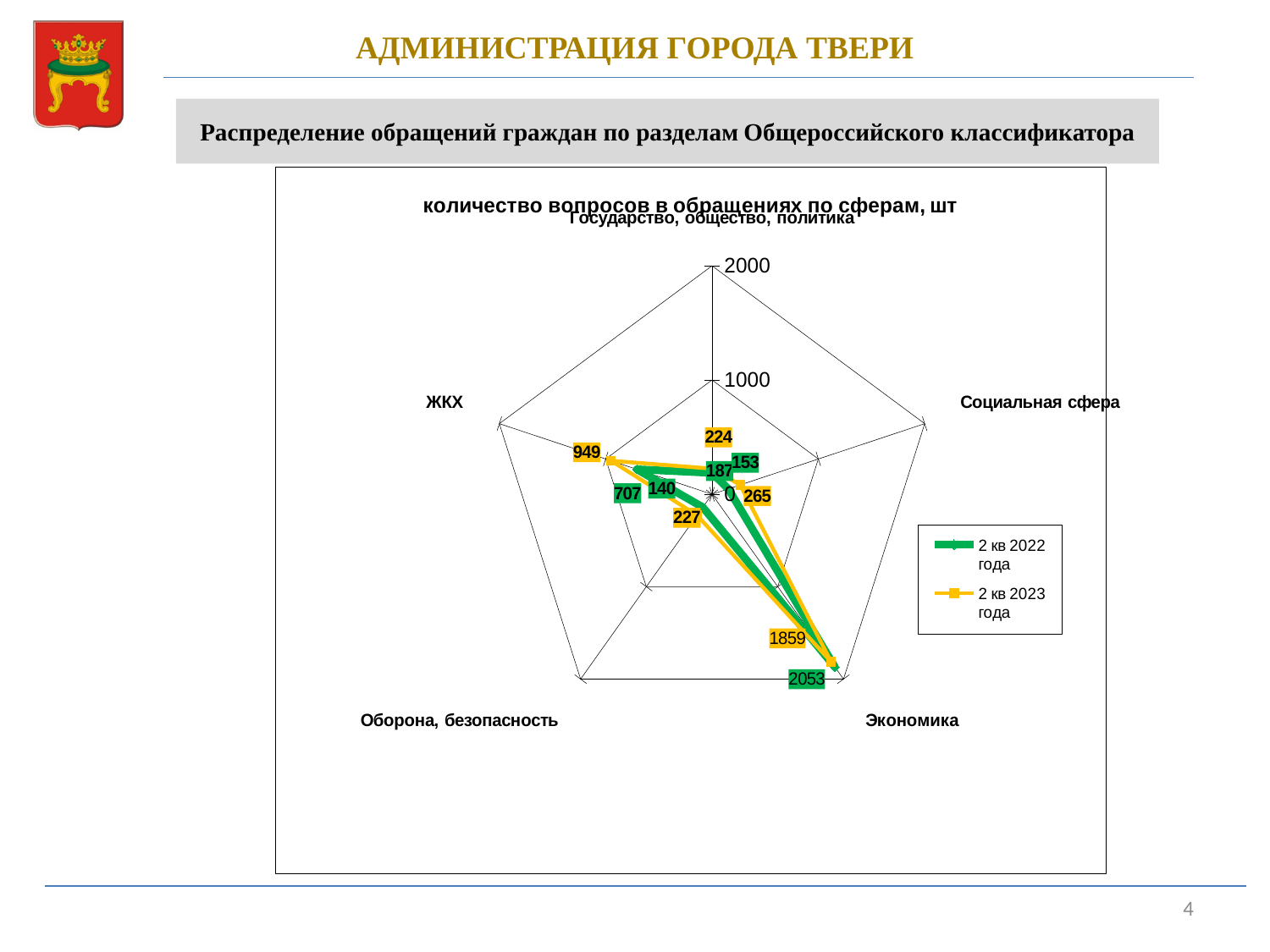
What is the value for Оборона, безопасность in the 2 кв 2022 года series? 140 How many series does the legend list? 2 Which category has the lowest value in the 2 кв 2022 года series? Оборона, безопасность What is the value for ЖКХ in the 2 кв 2023 года series? 949 How many categories (axes) does the radar chart have? 5 What is the value for Экономика in the 2 кв 2022 года series? 2053 What kind of chart is shown on the slide? Radar chart Which category has the highest value in the 2 кв 2023 года series? Экономика What is the difference between the 2 кв 2022 года and 2 кв 2023 года values for Экономика? 194 What is the value for Социальная сфера in the 2 кв 2023 года series? 265 For ЖКХ, which series has the larger value: 2 кв 2022 года or 2 кв 2023 года? 2 кв 2023 года What is the title of the chart? количество вопросов в обращениях по сферам, шт